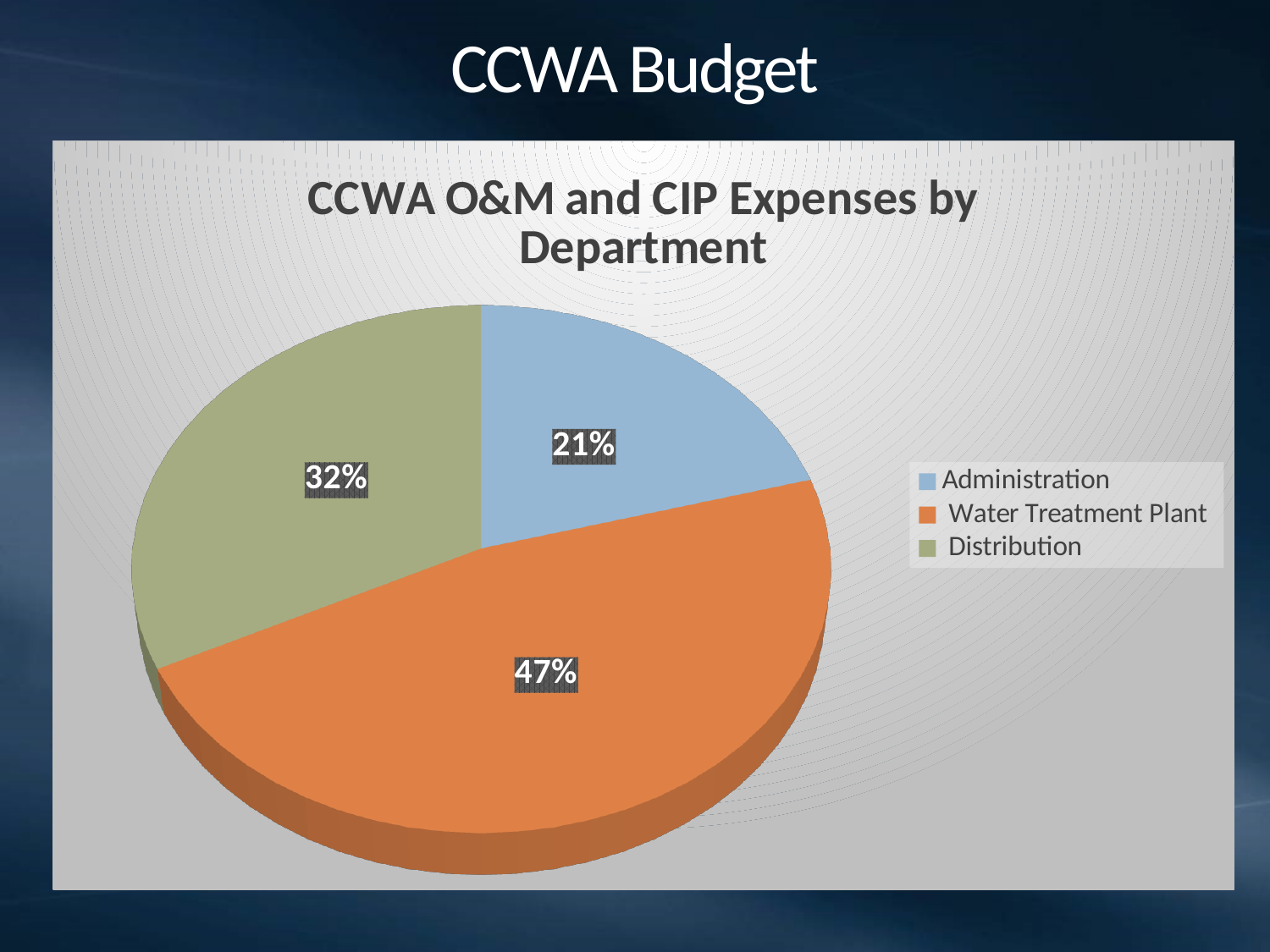
What is the difference in percentage points between the Water Treatment Plant share and the Distribution share? 15 percentage points What share of expenses does Distribution account for? 32% What share of expenses does Administration account for? 21% Which department has the largest share of expenses? Water Treatment Plant Which has a larger share, Distribution or Administration? Distribution How many departments are shown in the pie chart? 3 What kind of chart is shown on the slide? Pie chart Which department has the smallest share of expenses? Administration What is the title of the chart? CCWA O&M and CIP Expenses by Department How many entries does the legend list? 3 What share of expenses does the Water Treatment Plant account for? 47% What colour represents the Water Treatment Plant slice? Orange